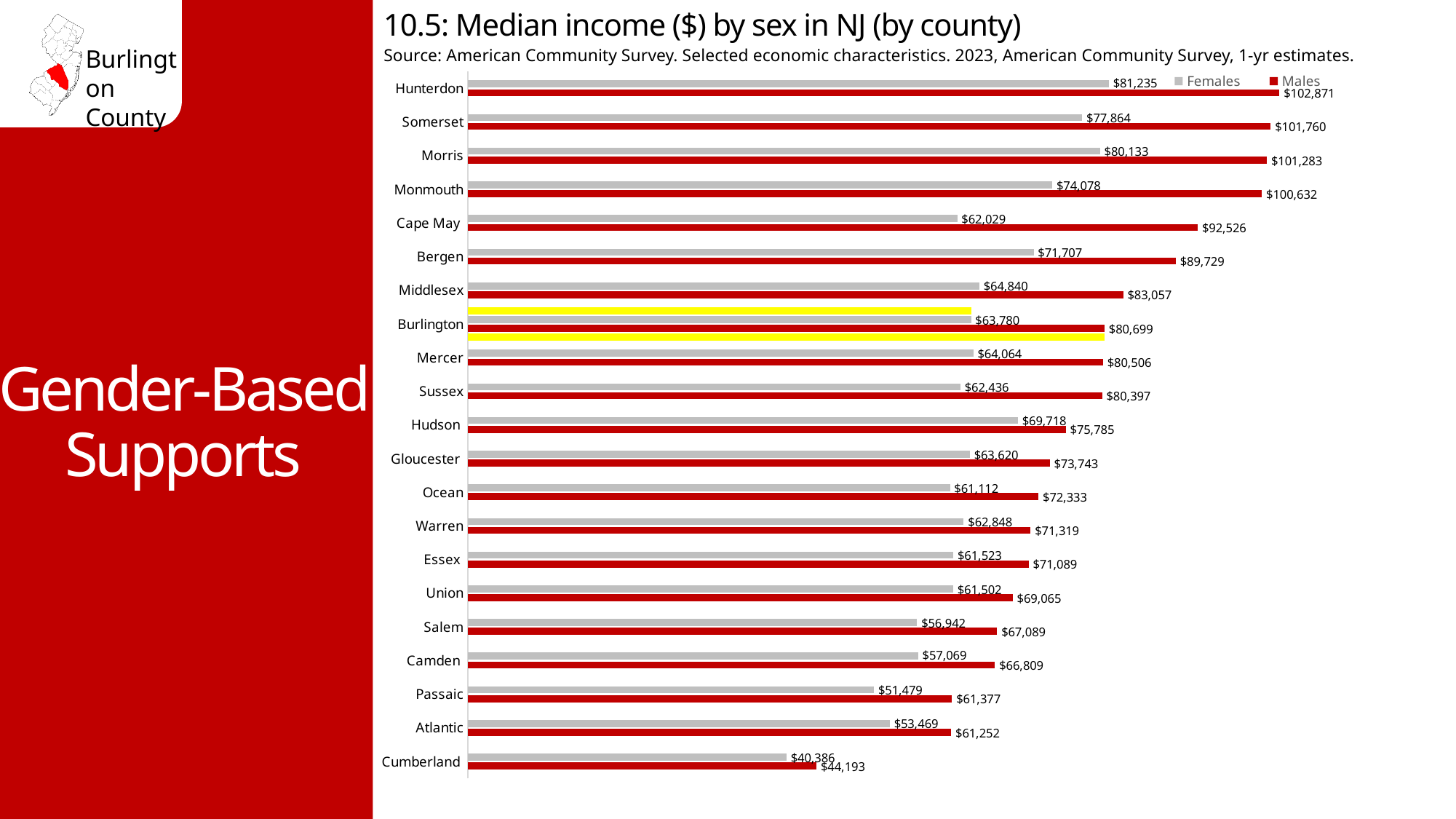
How many counties are shown in the chart? 21 Which county has the lowest median income for females? Cumberland What is the median income for males in Cape May County? $92,526 How many series does the legend list? 2 What type of chart is shown on the slide? Bar chart Which is larger, the female median income in Morris County or in Somerset County? Morris What is the difference between the male and female median incomes in Cumberland County? $3,807 Which county has the highest median income for males? Hunterdon What is the median income for females in Burlington County? $63,780 What is the median income for males in Burlington County? $80,699 What is the difference between the male and female median incomes in Burlington County? $16,919 What is the median income for females in Hudson County? $69,718